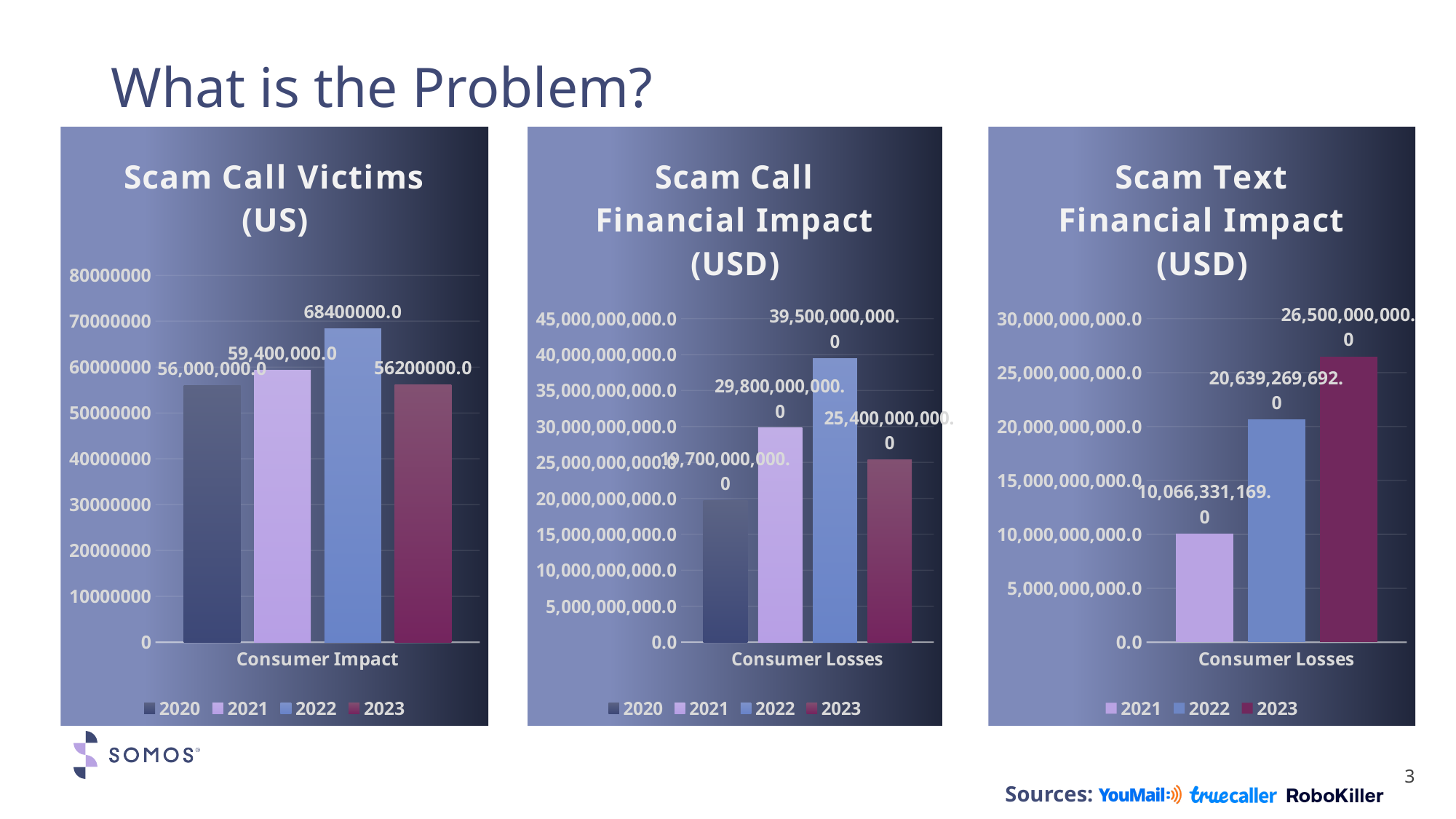
In the Scam Text Financial Impact (USD) chart, how many series does the legend list? 3 In the Scam Call Financial Impact (USD) chart, what is the difference between the 2022 and 2020 values? 19,800,000,000.0 In the Scam Call Victims (US) chart, what is the difference between the 2022 and 2023 values? 12200000.0 In the Scam Call Victims (US) chart, how many series does the legend list? 4 In the Scam Call Financial Impact (USD) chart, which is larger, the value for 2020 or the value for 2023? 2023 In the Scam Call Victims (US) chart, what is the value for 2022? 68400000.0 In the Scam Text Financial Impact (USD) chart, what is the value for 2021? 10,066,331,169.0 In the Scam Call Financial Impact (USD) chart, which year has the highest value? 2022 In the Scam Call Financial Impact (USD) chart, what is the value for 2021? 29,800,000,000.0 In the Scam Text Financial Impact (USD) chart, do the values rise or fall from 2021 to 2023? rise What kind of chart is the Scam Text Financial Impact (USD) chart? bar chart In the Scam Call Victims (US) chart, which year has the lowest value? 2020